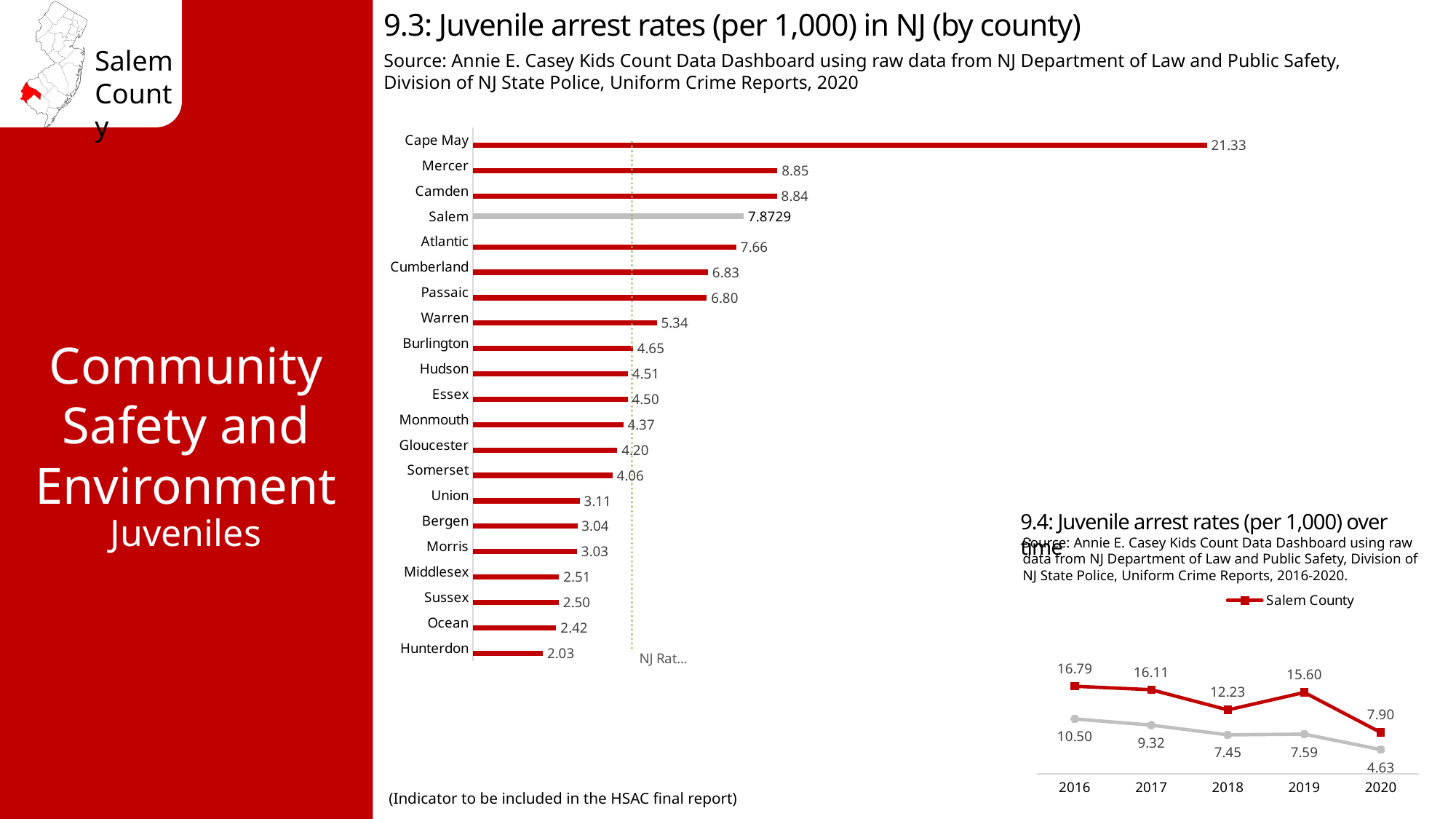
In the chart '9.3: Juvenile arrest rates (per 1,000) in NJ (by county)', how many counties are shown? 21 In the chart '9.3: Juvenile arrest rates (per 1,000) in NJ (by county)', which has a higher value, Warren or Burlington? Warren In the chart '9.3: Juvenile arrest rates (per 1,000) in NJ (by county)', which county has the lowest juvenile arrest rate? Hunterdon In the chart '9.4: Juvenile arrest rates (per 1,000) over time', what is the difference between the Salem County values for 2016 and 2020? 8.89 In the chart '9.3: Juvenile arrest rates (per 1,000) in NJ (by county)', which county has the highest juvenile arrest rate? Cape May In the chart '9.3: Juvenile arrest rates (per 1,000) in NJ (by county)', what is the value for Cumberland? 6.83 In the chart '9.4: Juvenile arrest rates (per 1,000) over time', which series is listed in the legend? Salem County In the chart '9.3: Juvenile arrest rates (per 1,000) in NJ (by county)', what is the value for Salem? 7.8729 In the chart '9.3: Juvenile arrest rates (per 1,000) in NJ (by county)', what is the difference between the values for Cape May and Mercer? 12.48 What kind of chart is '9.3: Juvenile arrest rates (per 1,000) in NJ (by county)'? Bar chart In the chart '9.4: Juvenile arrest rates (per 1,000) over time', what is the Salem County value for 2018? 12.23 In the chart '9.4: Juvenile arrest rates (per 1,000) over time', in which year is the Salem County value lowest? 2020